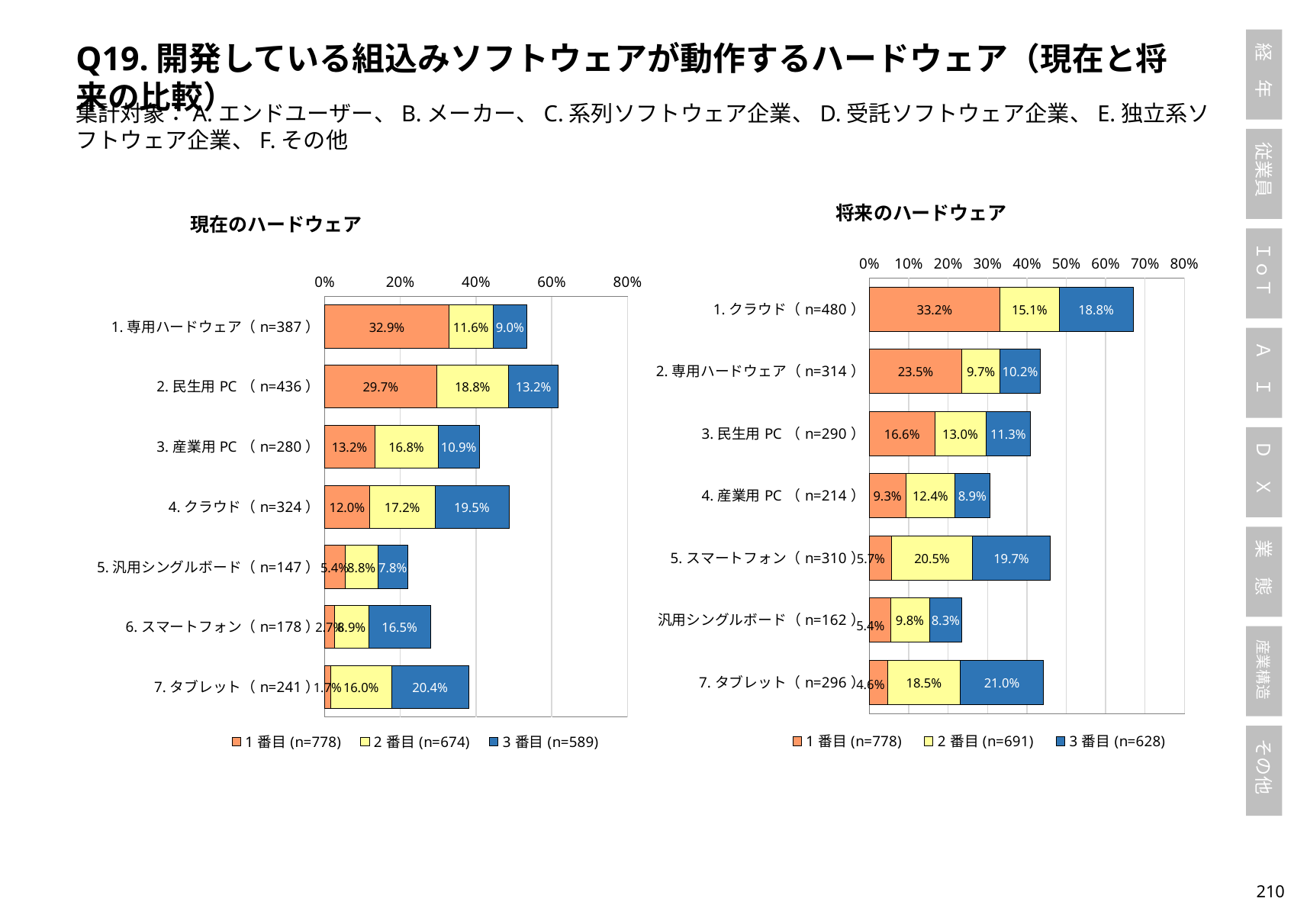
In the 将来のハードウェア chart, which is larger: the 3 番目 value for 1. クラウド or the 3 番目 value for 5. スマートフォン? 5. スマートフォン In the 現在のハードウェア chart, what is the 1 番目 value for 1. 専用ハードウェア? 32.9% In the 現在のハードウェア chart, what is the total of the stacked bar for 2. 民生用 PC? 61.7% In the 将来のハードウェア chart, what is the 3 番目 value for 7. タブレット? 21.0% In the 現在のハードウェア chart, what is the difference between the 2 番目 values for 2. 民生用 PC and 1. 専用ハードウェア? 7.2% How many series does the legend of the 将来のハードウェア chart list? 3 How many categories are shown in the 現在のハードウェア chart? 7 In the 将来のハードウェア chart, which category has the highest 1 番目 value? 1. クラウド In the 将来のハードウェア chart, what is the n value shown in the legend for 2 番目? n=691 What kind of chart is the 現在のハードウェア chart? Stacked bar chart In the 将来のハードウェア chart, what is the total of the stacked bar for 1. クラウド? 67.1% In the 現在のハードウェア chart, which category has the lowest 1 番目 value? 7. タブレット